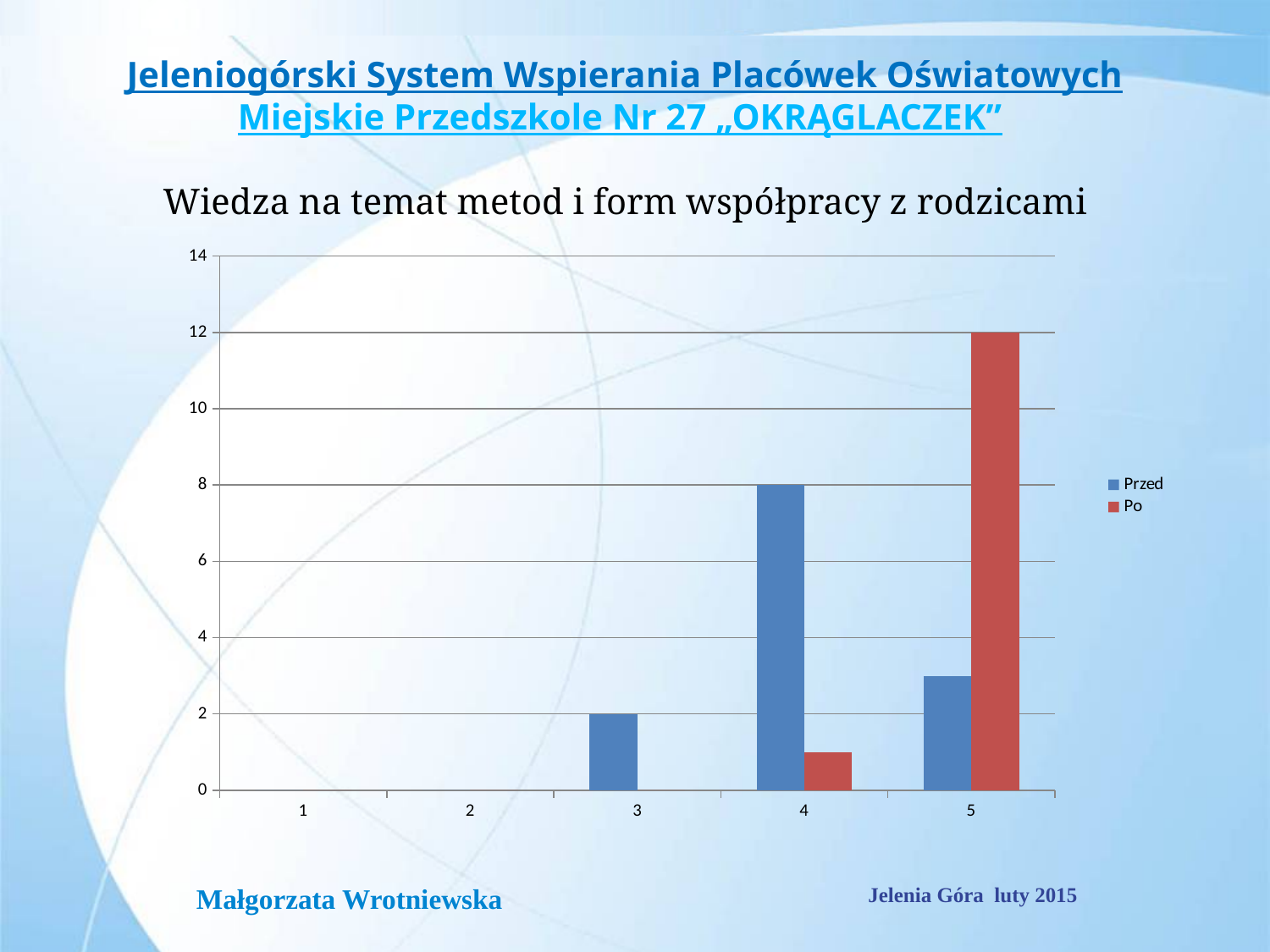
Which category has the highest value in the Po series? 5 Which category has the highest value in the Przed series? 4 What are the two series named in the legend? Przed and Po What is the value of the Po series for category 5? 12 Is the value of the Przed series for category 5 greater or less than 4? less What is the value of the Przed series for category 4? 8 Is the value of the Po series for category 4 greater or less than 2? less What is the difference between the Po value for category 5 and the Przed value for category 4? 4 How many series does the legend list? 2 How many categories are shown on the x axis? 5 What kind of chart is shown on the slide? bar chart What is the value of the Przed series for category 3? 2